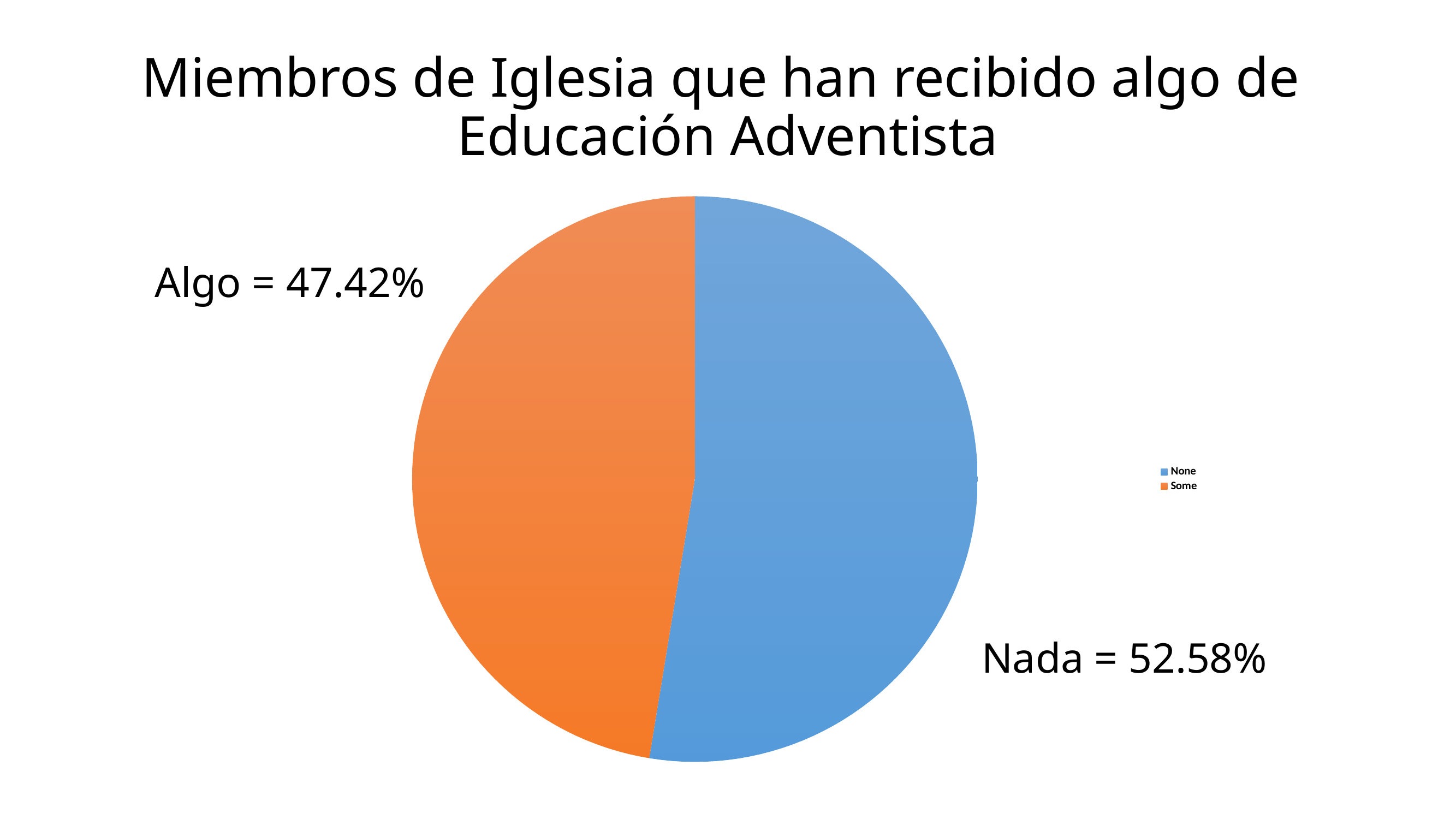
Which category has the largest share of the pie? Nada What colour is the None slice? blue What is the difference in percentage points between Nada and Algo? 5.16 What percentage is shown for Algo (Some)? 47.42% Which category has the smallest share of the pie? Algo What kind of chart is shown on the slide? pie chart Which slice is larger, Nada or Algo? Nada What percentage is shown for Nada (None)? 52.58% Is the share for Nada greater or less than 50%? greater What is the title of the chart? Miembros de Iglesia que han recibido algo de Educación Adventista How many entries does the legend list? 2 How many slices does the pie chart have? 2